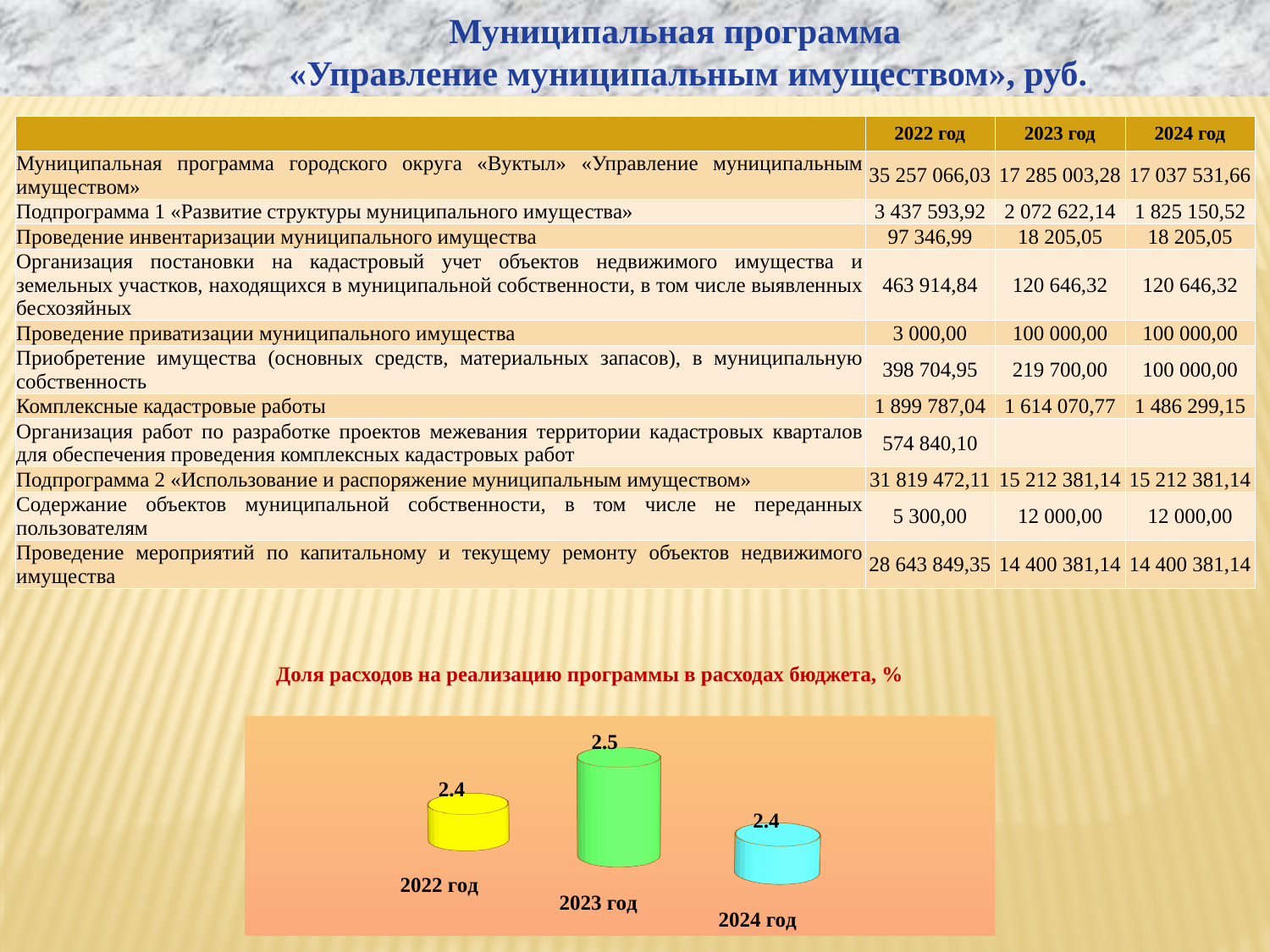
What is the value for 2024 год in the chart? 2.4 What colour is the bar for 2023 год? Green What is the value for 2022 год in the chart? 2.4 Does the value rise or fall from 2022 год to 2023 год? Rise How many years are shown in the chart? 3 What kind of chart is shown at the bottom of the slide? Bar chart What is the difference between the values for 2023 год and 2022 год? 0.1 What is the title of the chart? Доля расходов на реализацию программы в расходах бюджета, % Does the value rise or fall from 2023 год to 2024 год? Fall What is the value for 2023 год in the chart? 2.5 Which year has the highest value in the chart? 2023 год Which is larger, the value for 2023 год or the value for 2024 год? 2023 год